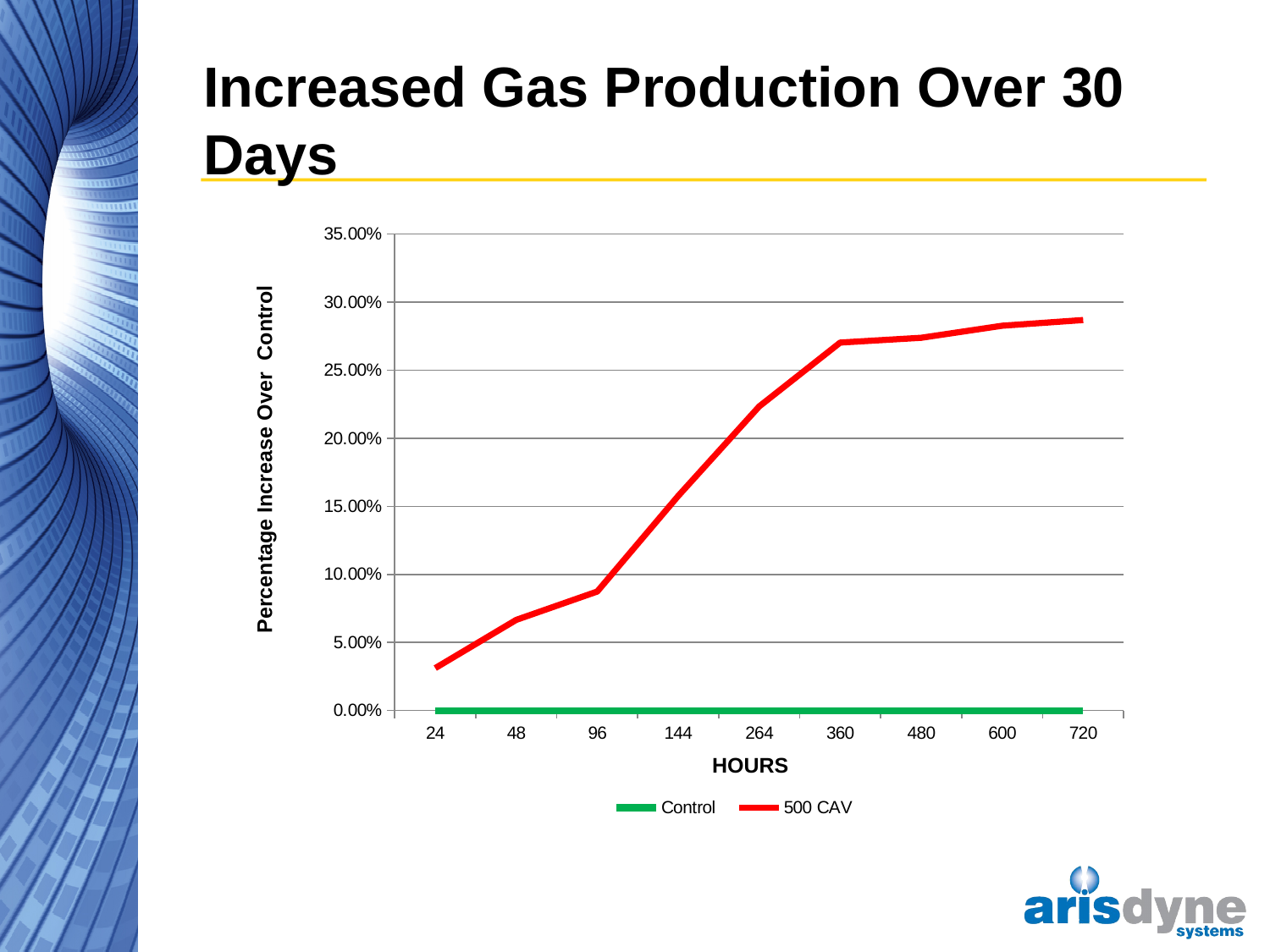
What is the label of the x axis? HOURS Is the value for 500 CAV at 720 hours greater or less than 30.00%? less Does the 500 CAV series rise or fall as hours increase along the x axis? rise How many series does the legend list? 2 At 360 hours, which series has the larger value, Control or 500 CAV? 500 CAV How many hour values are marked along the x axis? 9 What kind of chart is shown on the slide? line chart Is the value for 500 CAV at 24 hours greater or less than 5.00%? less Is the value for 500 CAV at 264 hours greater or less than 20.00%? greater What is the value of the Control series at 360 hours? 0.00% At which hour value is the 500 CAV series lowest? 24 At which hour value is the 500 CAV series highest? 720